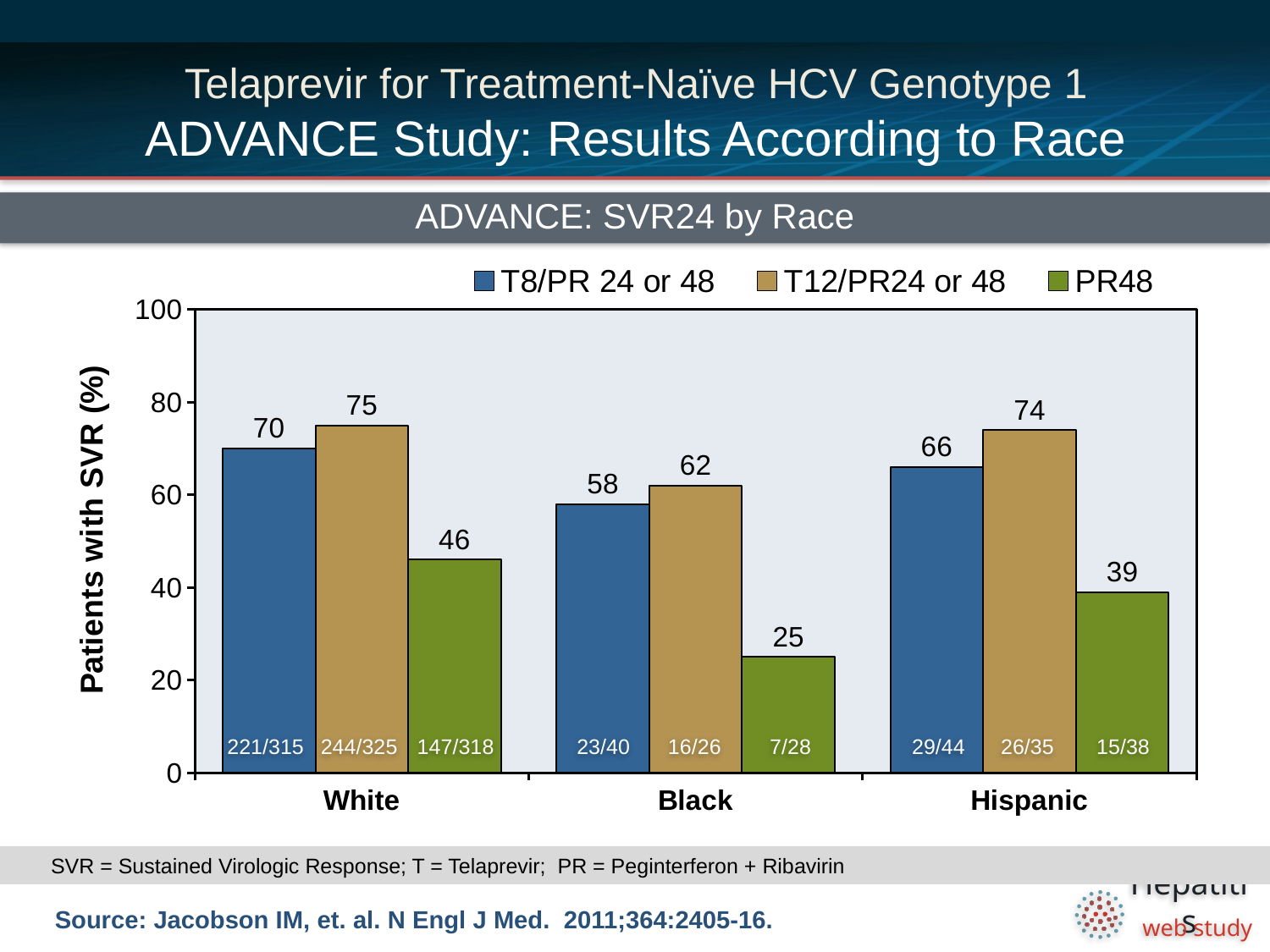
How many series does the legend list? 3 Which race category has the lowest SVR rate for the T12/PR24 or 48 group? Black What is the SVR rate for the T12/PR24 or 48 group among Hispanic patients? 74 What is the label of the y axis? Patients with SVR (%) Which is larger among Hispanic patients: the SVR rate for T8/PR 24 or 48 or for PR48? T8/PR 24 or 48 How many race categories are shown on the x axis? 3 What kind of chart is shown on the slide? Bar chart What is the chart's title? ADVANCE: SVR24 by Race Which race category has the highest SVR rate for the PR48 group? White What is the difference between the T12/PR24 or 48 and PR48 SVR rates among Black patients? 37 What is the SVR rate for the PR48 group among Black patients? 25 What is the SVR rate for the T8/PR 24 or 48 group among White patients? 70